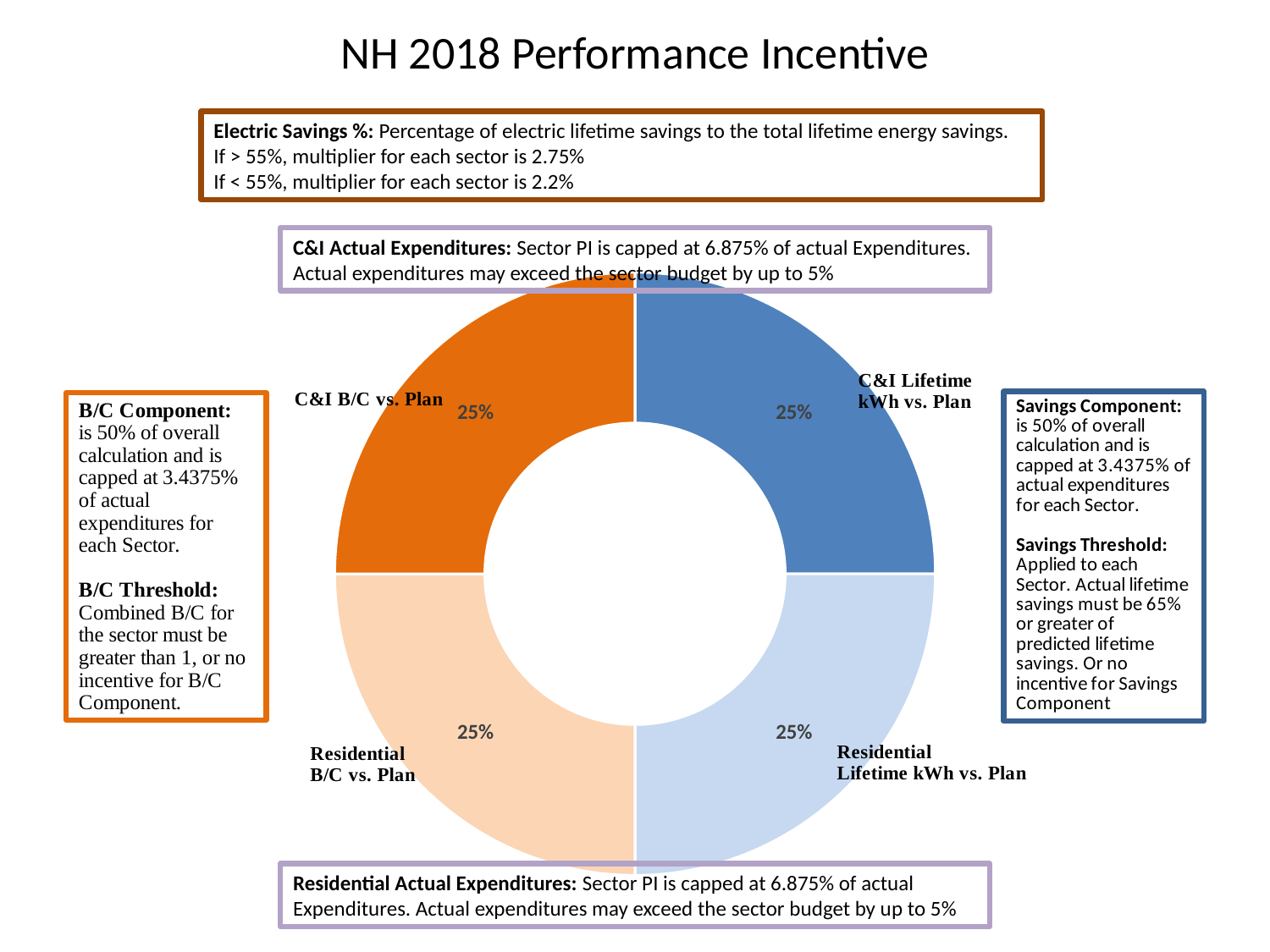
What is the value shown for the Residential B/C vs. Plan slice? 25% What is the difference between the C&I B/C vs. Plan slice and the Residential B/C vs. Plan slice? 0% What share of the doughnut chart do the two Residential slices make up together? 50% What is the value shown for the C&I Lifetime kWh vs. Plan slice? 25% How many slices does the doughnut chart have? 4 Which slice of the doughnut chart is coloured dark orange? C&I B/C vs. Plan Is the C&I Lifetime kWh vs. Plan slice larger than, smaller than, or equal to the Residential Lifetime kWh vs. Plan slice? Equal What is the value shown for the Residential Lifetime kWh vs. Plan slice? 25% What is the value shown for the C&I B/C vs. Plan slice? 25% What kind of chart is shown on the slide? Doughnut (pie) chart What share of the doughnut chart do the two C&I slices make up together? 50% What is the title of the slide containing the doughnut chart? NH 2018 Performance Incentive